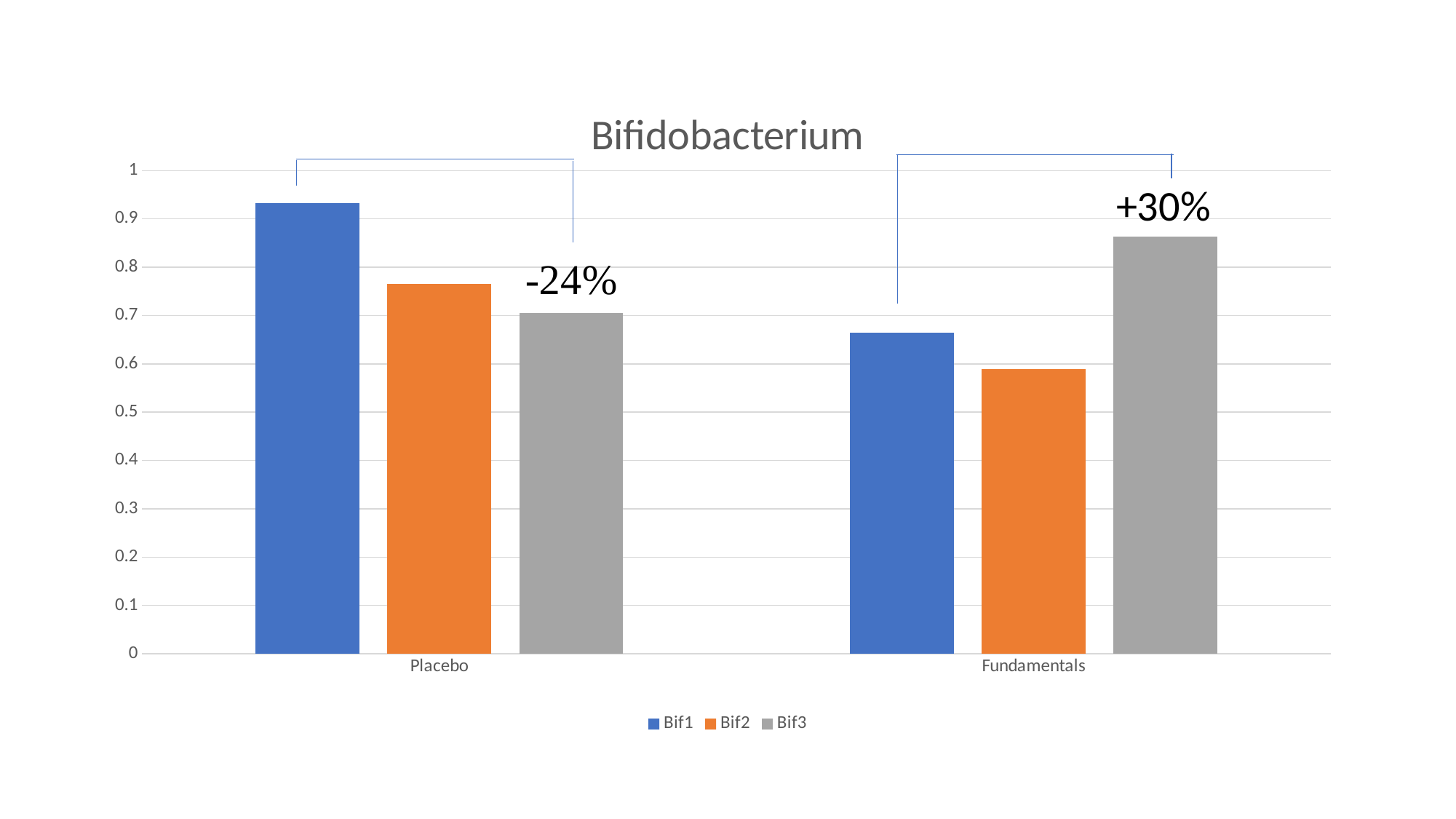
Which series has the highest bar in the Fundamentals group? Bif3 Which series has the lowest bar in the Fundamentals group? Bif2 What percentage change is annotated above the Bif3 bar in the Fundamentals group? +30% How many series does the legend list? 3 What is the title of the chart? Bifidobacterium How many categories are shown on the x axis? 2 Is the Bif1 bar for Placebo greater or less than 0.9? greater Which series has the lowest bar in the Placebo group? Bif3 What kind of chart is shown on the slide? bar chart Which series has the highest bar in the Placebo group? Bif1 Which is larger, the Bif1 bar for Placebo or the Bif1 bar for Fundamentals? Placebo